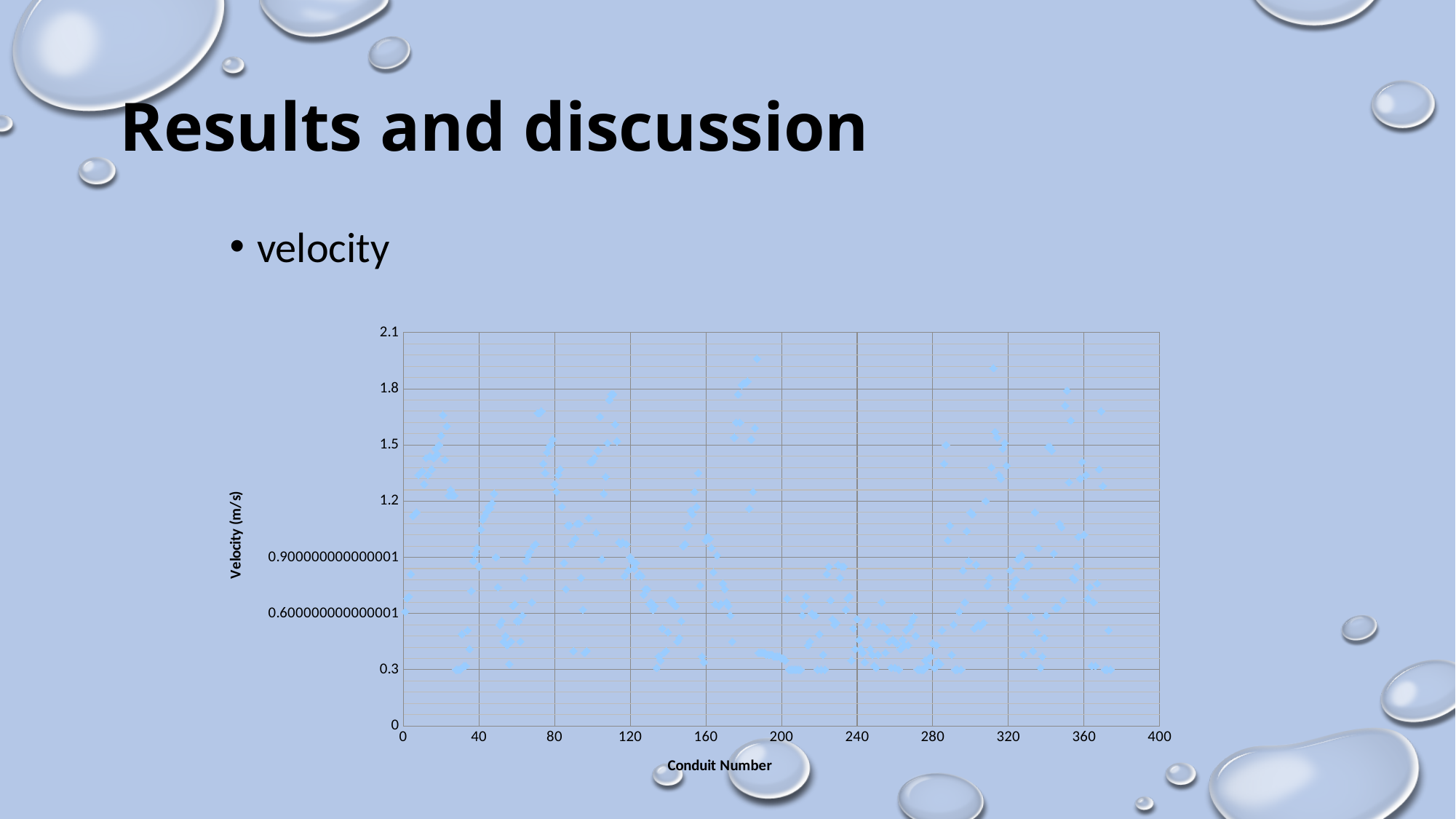
Is the highest plotted velocity value greater or less than 2.1? less What is the title of the horizontal axis of the chart? Conduit Number Are the velocity values for conduits around 260 greater or less than 0.9? less What kind of chart is shown on the slide? Scatter chart What is the title of the vertical axis of the chart? Velocity (m/s) Is the lowest plotted velocity value greater or less than 0.6? less